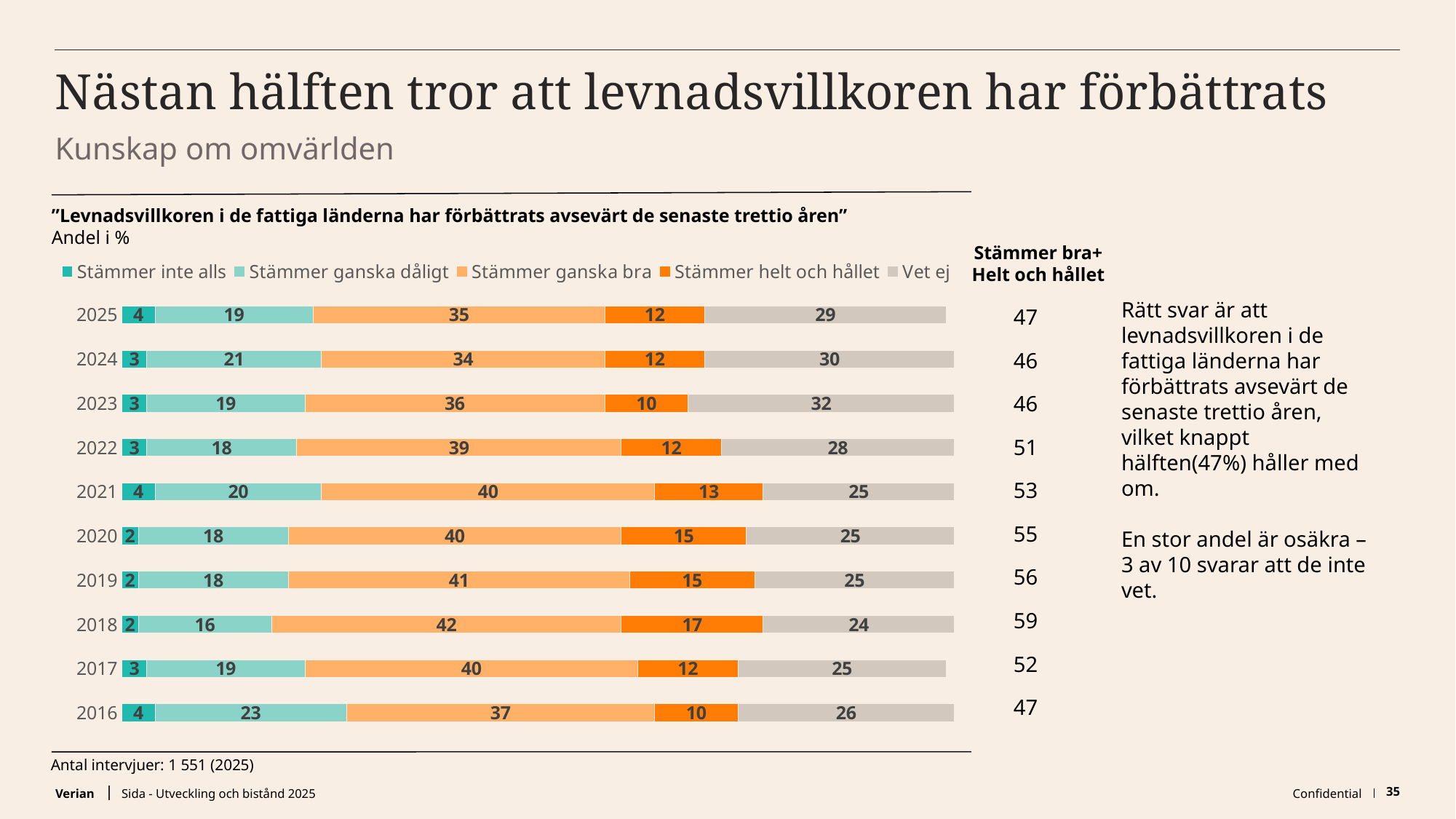
What is the value for "Vet ej" in 2023? 32 In which year is the "Stämmer ganska bra" value highest? 2018 How many years are shown in the chart? 10 What is the total of the stacked bar for 2025? 99 Which is larger, the "Stämmer helt och hållet" value for 2020 or for 2017? 2020 What is the difference between the "Stämmer ganska dåligt" values for 2016 and 2018? 7 How many series does the legend list? 5 What is the value for "Stämmer ganska bra" in 2025? 35 Which legend entry is shown in grey? Vet ej In which year is the "Vet ej" value lowest? 2018 What is the value for "Stämmer helt och hållet" in 2018? 17 What kind of chart is shown on the slide? Stacked bar chart